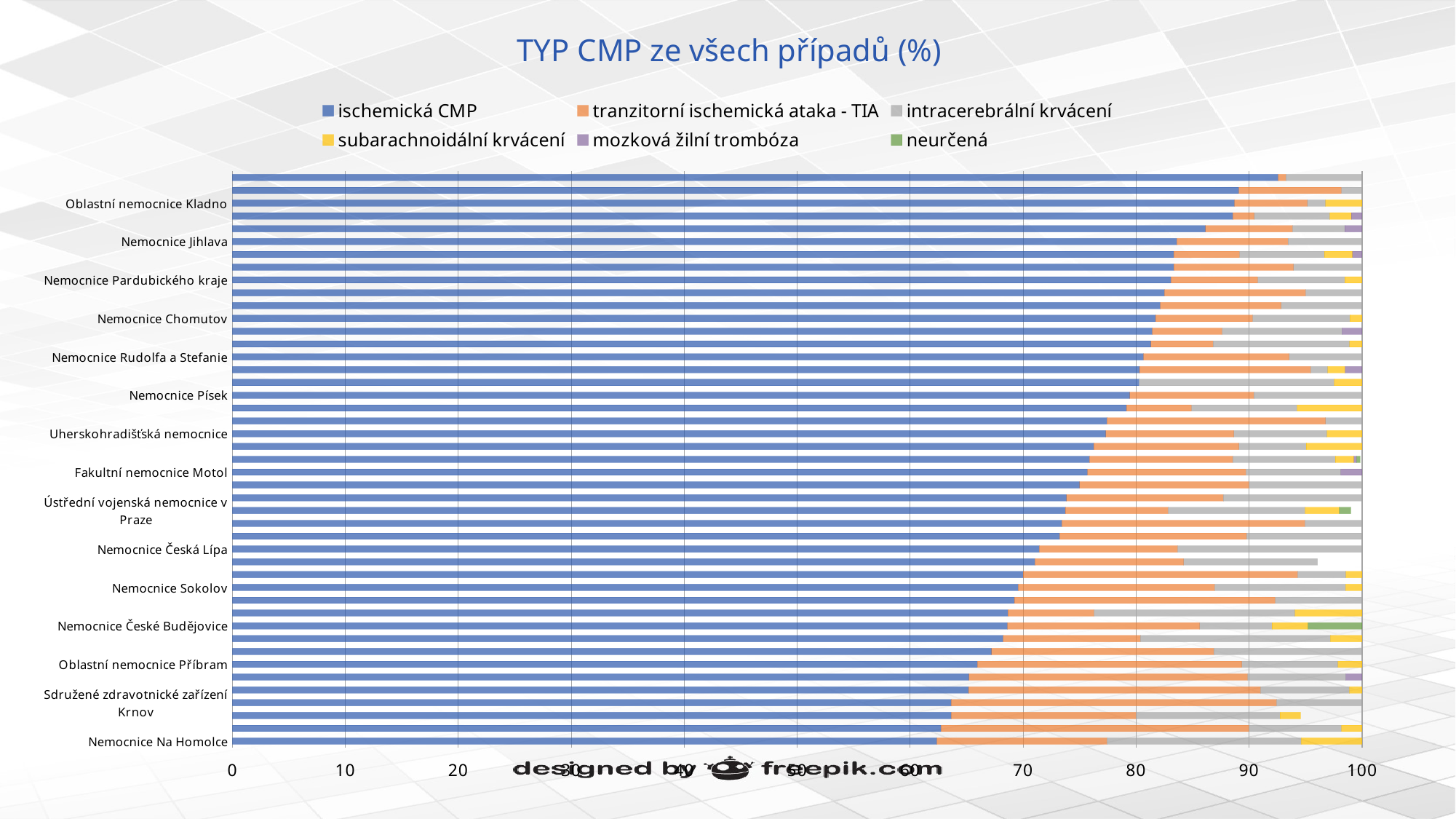
Is the ischemická CMP value for Nemocnice Na Homolce greater or less than 70? less Which series is shown in blue in the chart? ischemická CMP What is the title of the chart? TYP CMP ze všech případů (%) Is the ischemická CMP value for Nemocnice Sokolov greater or less than 60? greater Which has the larger ischemická CMP value, Nemocnice Písek or Nemocnice Česká Lípa? Nemocnice Písek Do the ischemická CMP values rise or fall going from the top of the chart to the bottom? fall What kind of chart is shown on the slide? stacked bar chart Is the ischemická CMP value for Nemocnice Jihlava greater or less than 80? greater Which has the larger ischemická CMP value, Oblastní nemocnice Kladno or Nemocnice Na Homolce? Oblastní nemocnice Kladno How many series does the legend list? 6